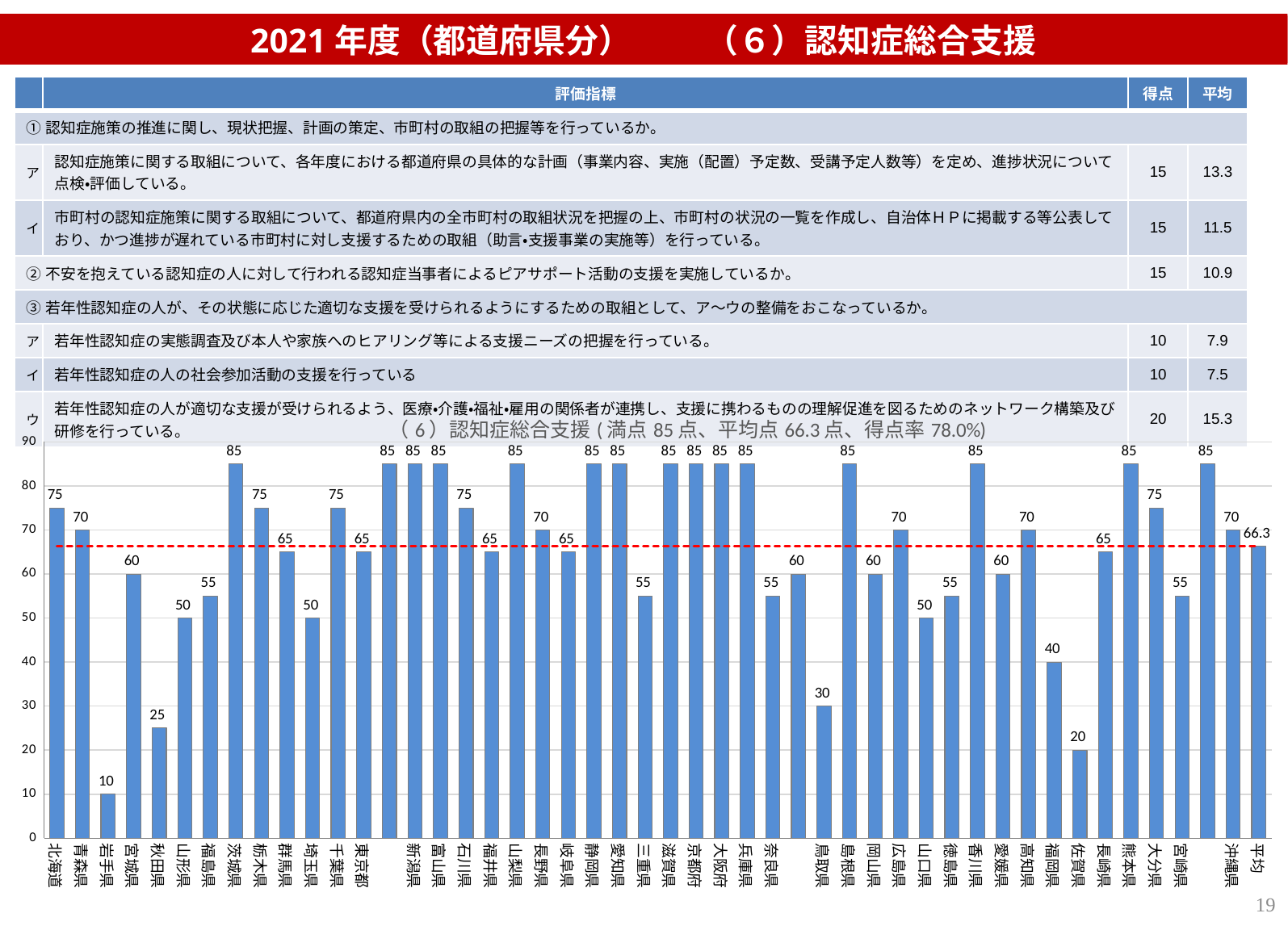
Which has a larger value, 宮城県 or 福島県? 宮城県 Which has a larger value, 秋田県 or 佐賀県? 秋田県 Is the value for 福岡県 greater or less than 50? less What kind of chart is shown on the slide? bar chart What is the value for 岩手県 in the bar chart? 10 What is the value shown for 平均 at the right end of the bar chart? 66.3 What is the difference between the values for 広島県 and 山口県? 20 What is the difference between the values for 北海道 and 岩手県? 65 Which prefecture has the lowest value in the bar chart? 岩手県 What is the value for 鳥取県 in the bar chart? 30 According to the chart title, what is the 得点率 (score rate)? 78.0% What is the value for 茨城県 in the bar chart? 85